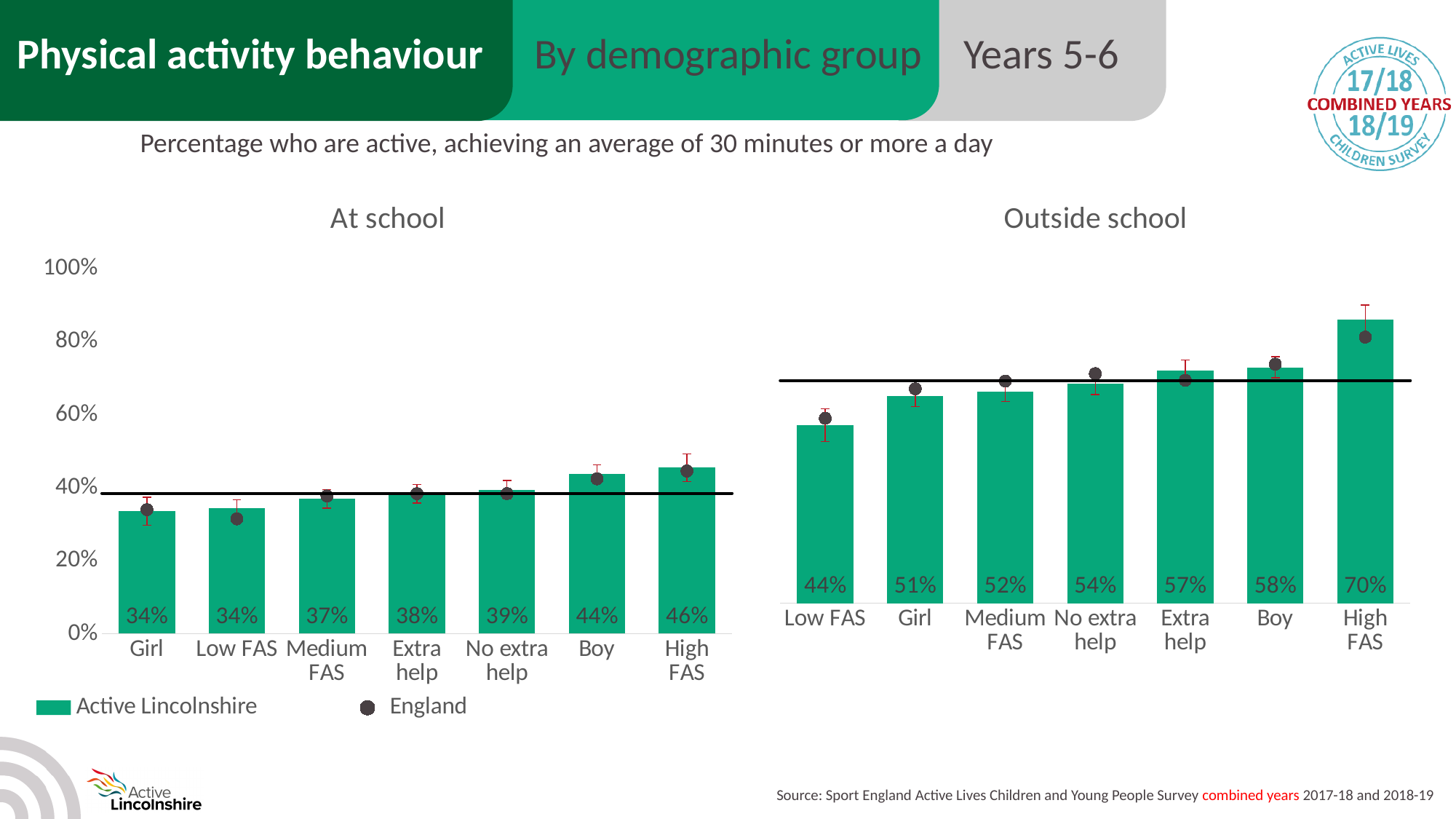
In the 'Outside school' chart, what is the Active Lincolnshire value for Extra help? 57% In the 'Outside school' chart, which is larger for Active Lincolnshire: Girl or Medium FAS? Medium FAS In the 'Outside school' chart, what is the difference between the High FAS and Boy Active Lincolnshire values? 12% How many categories are shown in the 'At school' chart? 7 In the 'At school' chart, what is the Active Lincolnshire value for Boy? 44% In the 'At school' chart, is the Active Lincolnshire value for Girl greater or less than 40%? less How many series does the legend list? 2 In the 'At school' chart, which category has the highest Active Lincolnshire value? High FAS What kind of chart is the 'Outside school' chart? bar chart In the 'At school' chart, do the Active Lincolnshire values rise or fall from Girl to High FAS? rise In the 'Outside school' chart, which category has the lowest Active Lincolnshire value? Low FAS In the 'At school' chart, what is the difference between the High FAS and Girl Active Lincolnshire values? 12%